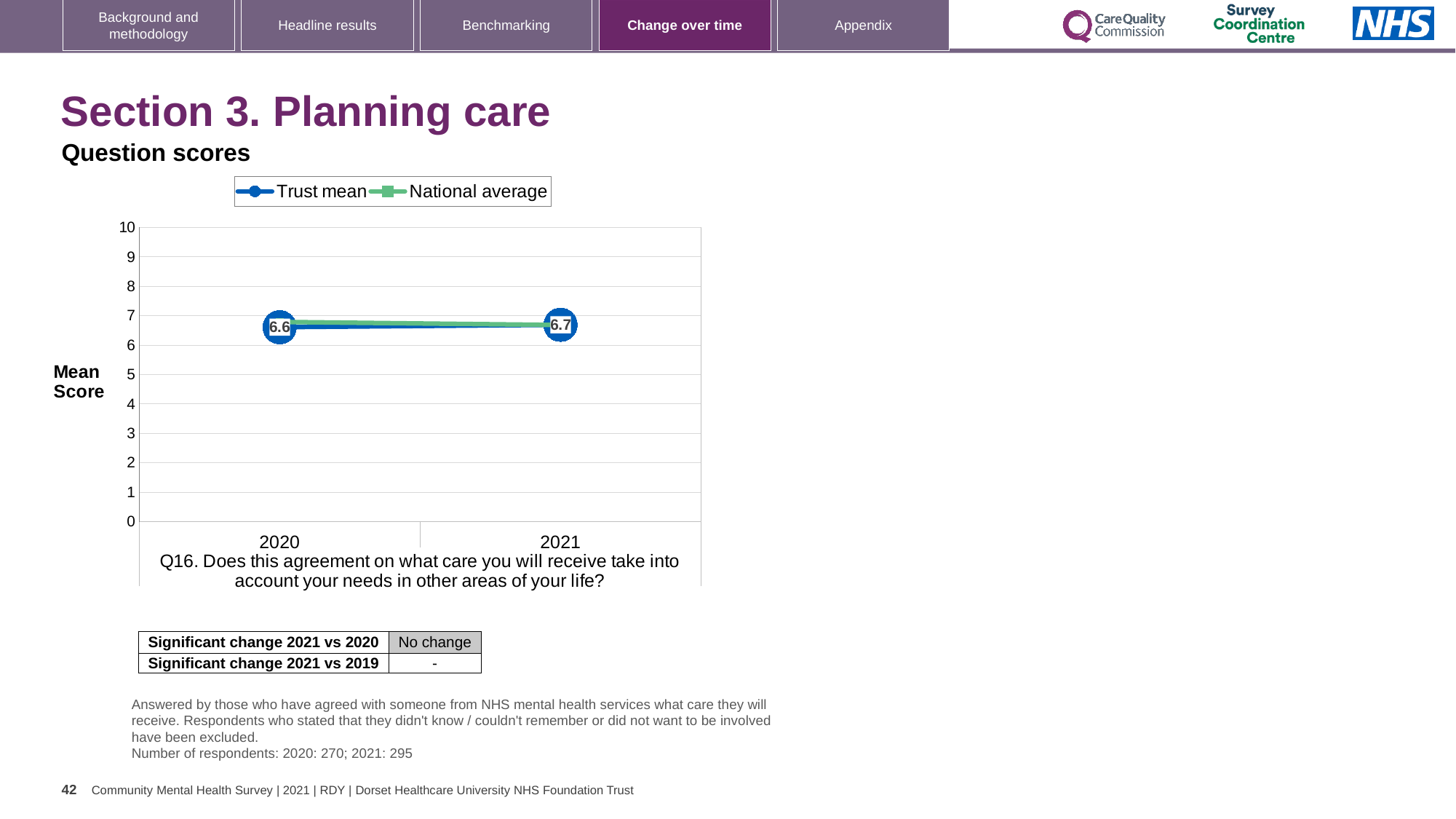
Which year has the higher Trust mean, 2020 or 2021? 2021 Does the Trust mean rise or fall from 2020 to 2021? rise What are the two series named in the legend? Trust mean and National average Is the Trust mean for 2020 greater or less than 5? greater What is the label on the y axis of the chart? Mean Score What is the Trust mean score for 2020? 6.6 By how much did the Trust mean change from 2020 to 2021? 0.1 What kind of chart is shown on the slide? line chart Is the National average for 2021 greater or less than 8? less How many years are shown on the x axis of the chart? 2 What is the Trust mean score for 2021? 6.7 How many series does the legend list? 2